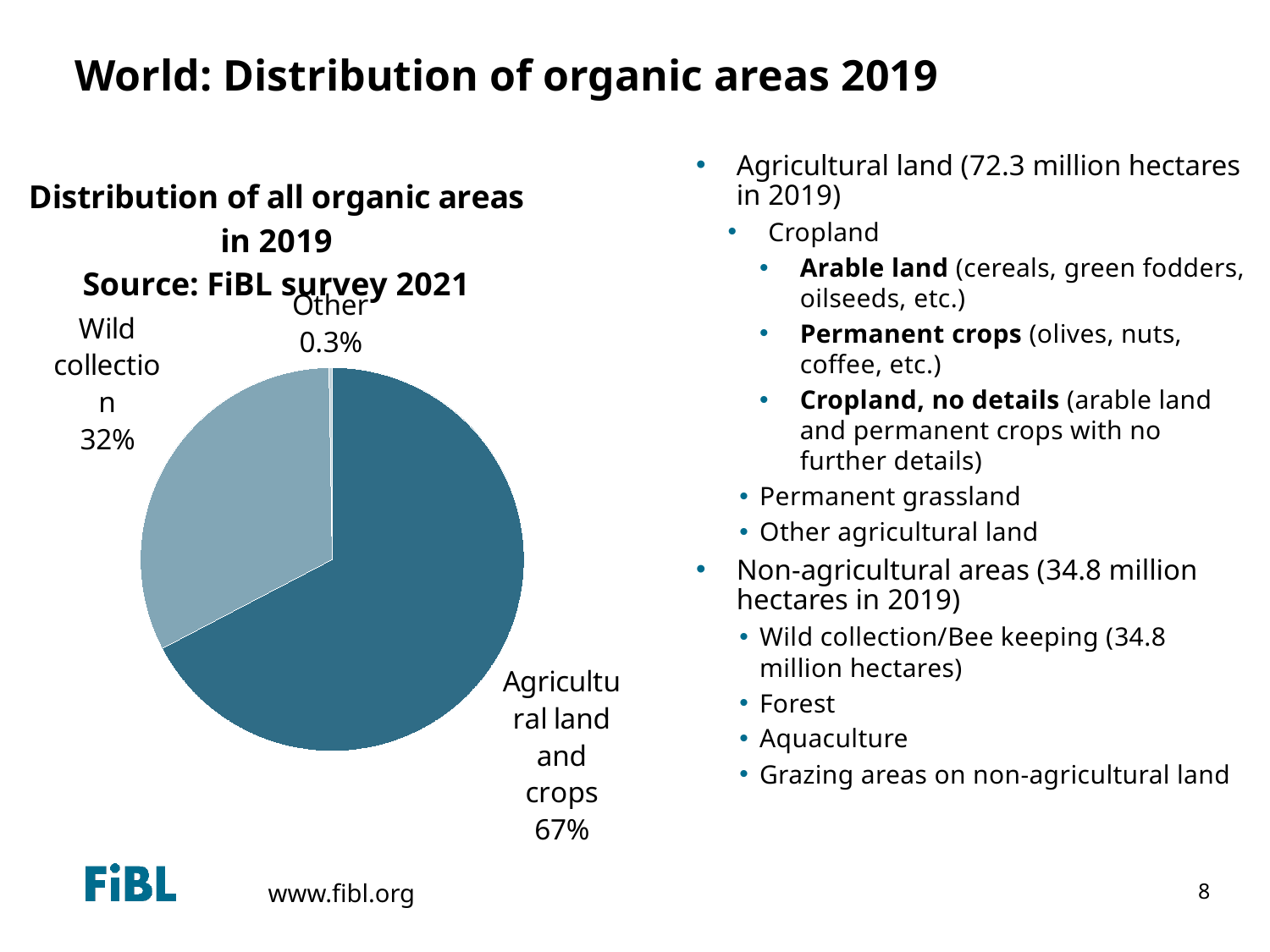
What share of the pie does Wild collection have? 32% What share of the pie does Agricultural land and crops have? 67% Which is larger, the share for Wild collection or the share for Other? Wild collection What is the title of the pie chart? Distribution of all organic areas in 2019 Source: FiBL survey 2021 What kind of chart is shown on the slide? pie chart Is the share for Agricultural land and crops greater or less than 50%? greater What share of the pie does Other have? 0.3% How many slices does the pie chart have? 3 Which slice of the pie is the largest? Agricultural land and crops Which slice of the pie is the smallest? Other What is the difference in percentage points between the Agricultural land and crops share and the Wild collection share? 35